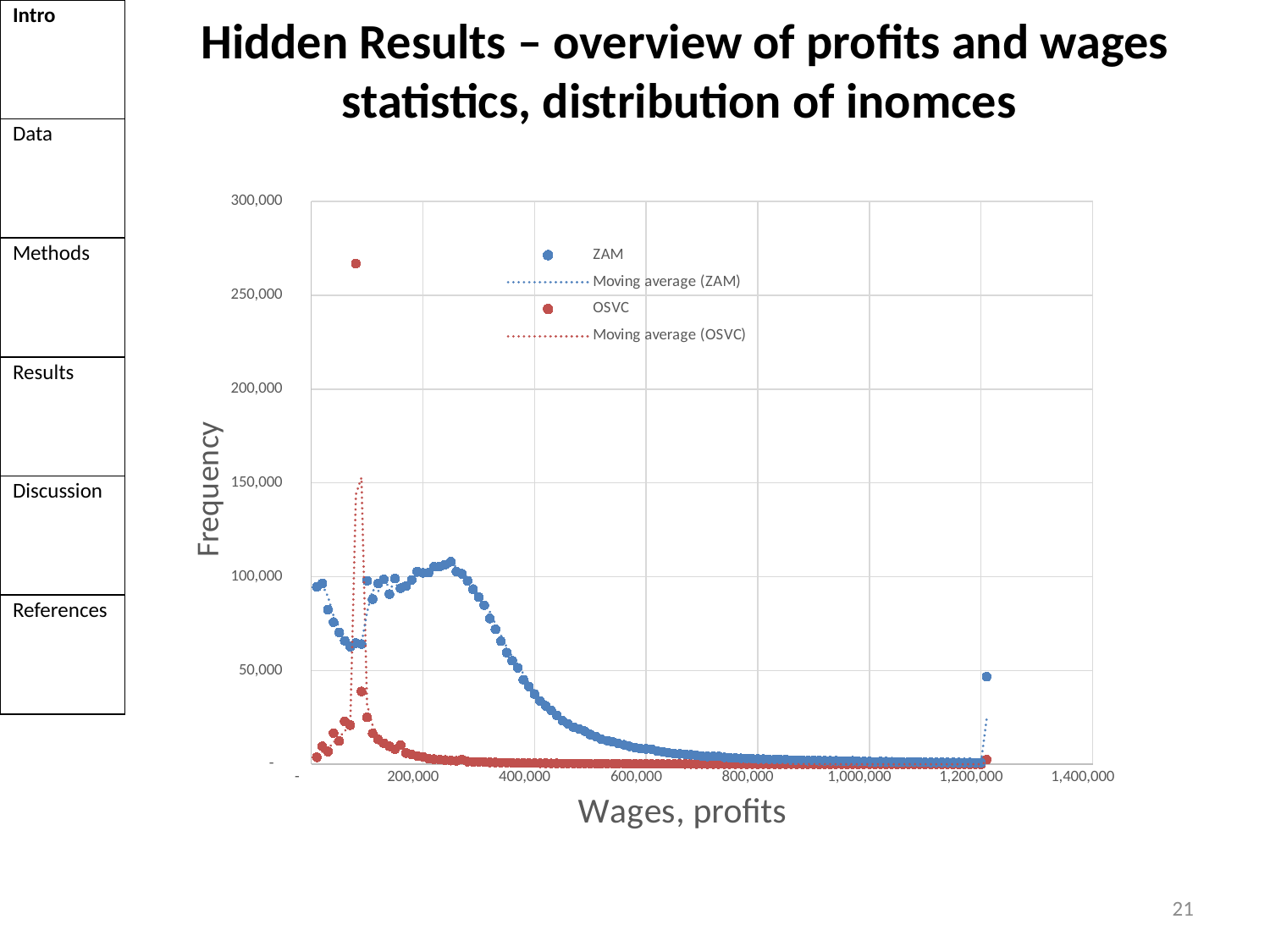
Is the highest ZAM point on the chart greater or less than 150,000? less At an x value of about 400,000, which series has the larger frequency, ZAM or OSVC? ZAM How many entries does the chart legend list? 4 Do the OSVC frequency values rise or fall as profits increase from 200,000 to 600,000? fall Is the ZAM point plotted near 1,200,000 on the x axis greater or less than 100,000? less What is the largest value shown on the vertical axis of the chart? 300,000 What kind of chart is shown on the slide? Scatter chart What is the title of the vertical axis of the chart? Frequency What is the title of the horizontal axis of the chart? Wages, profits Is the highest OSVC point on the chart greater or less than 250,000? greater Do the ZAM frequency values rise or fall as wages increase from 300,000 to 1,000,000? fall Which series reaches the highest frequency value on the chart, ZAM or OSVC? OSVC